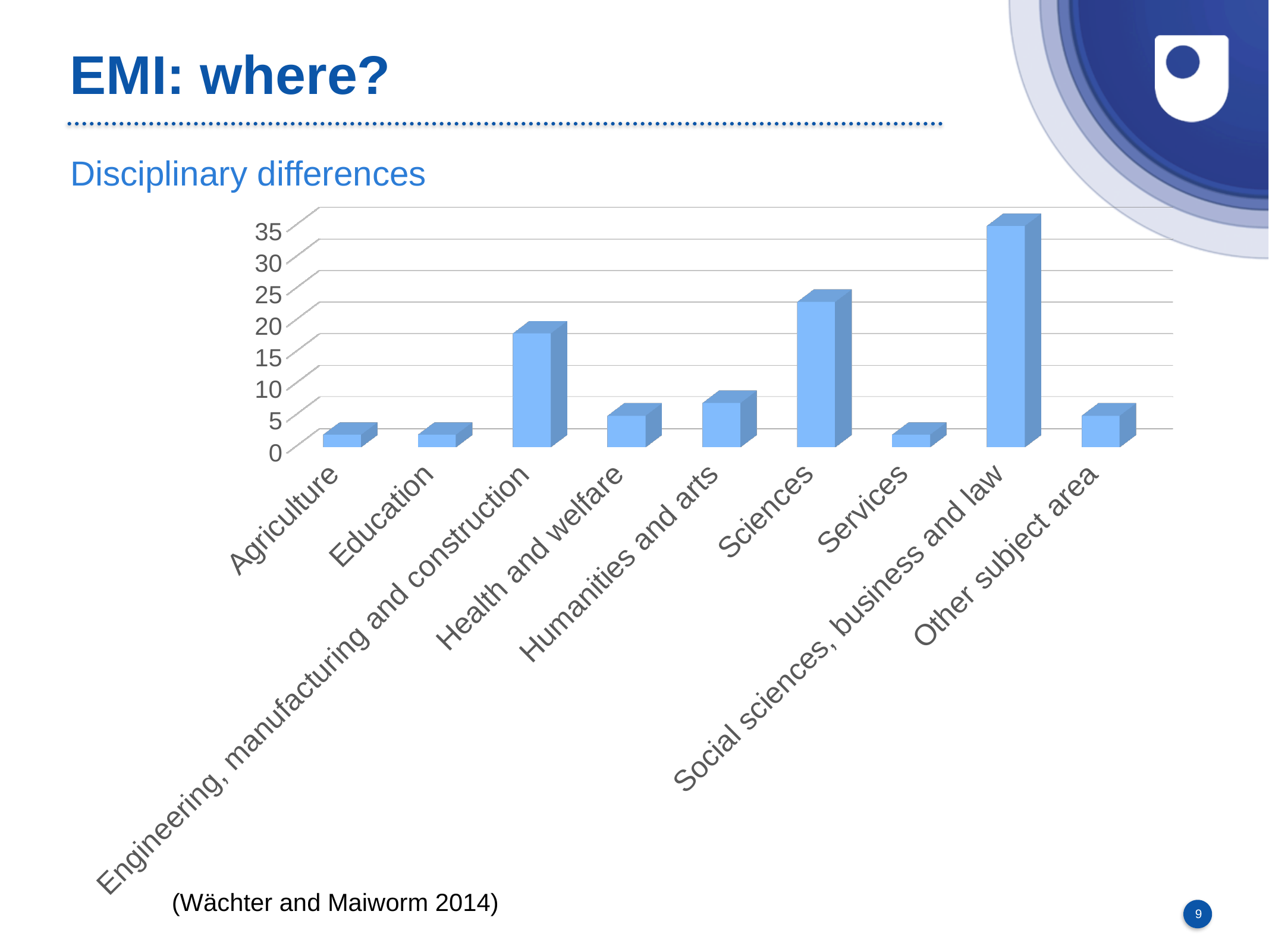
Is the value for Humanities and arts greater or less than 10? less Which category has the highest bar in the chart? Social sciences, business and law How many subject area categories are shown on the x axis? 9 Is the value for Sciences greater or less than 20? greater Which is larger, the value for Sciences or the value for Engineering, manufacturing and construction? Sciences Which is larger, the value for Social sciences, business and law or the value for Sciences? Social sciences, business and law What source is cited below the chart? (Wächter and Maiworm 2014) What kind of chart is shown on the slide? bar chart Which is larger, the value for Engineering, manufacturing and construction or the value for Humanities and arts? Engineering, manufacturing and construction Is the value for Engineering, manufacturing and construction greater or less than 10? greater